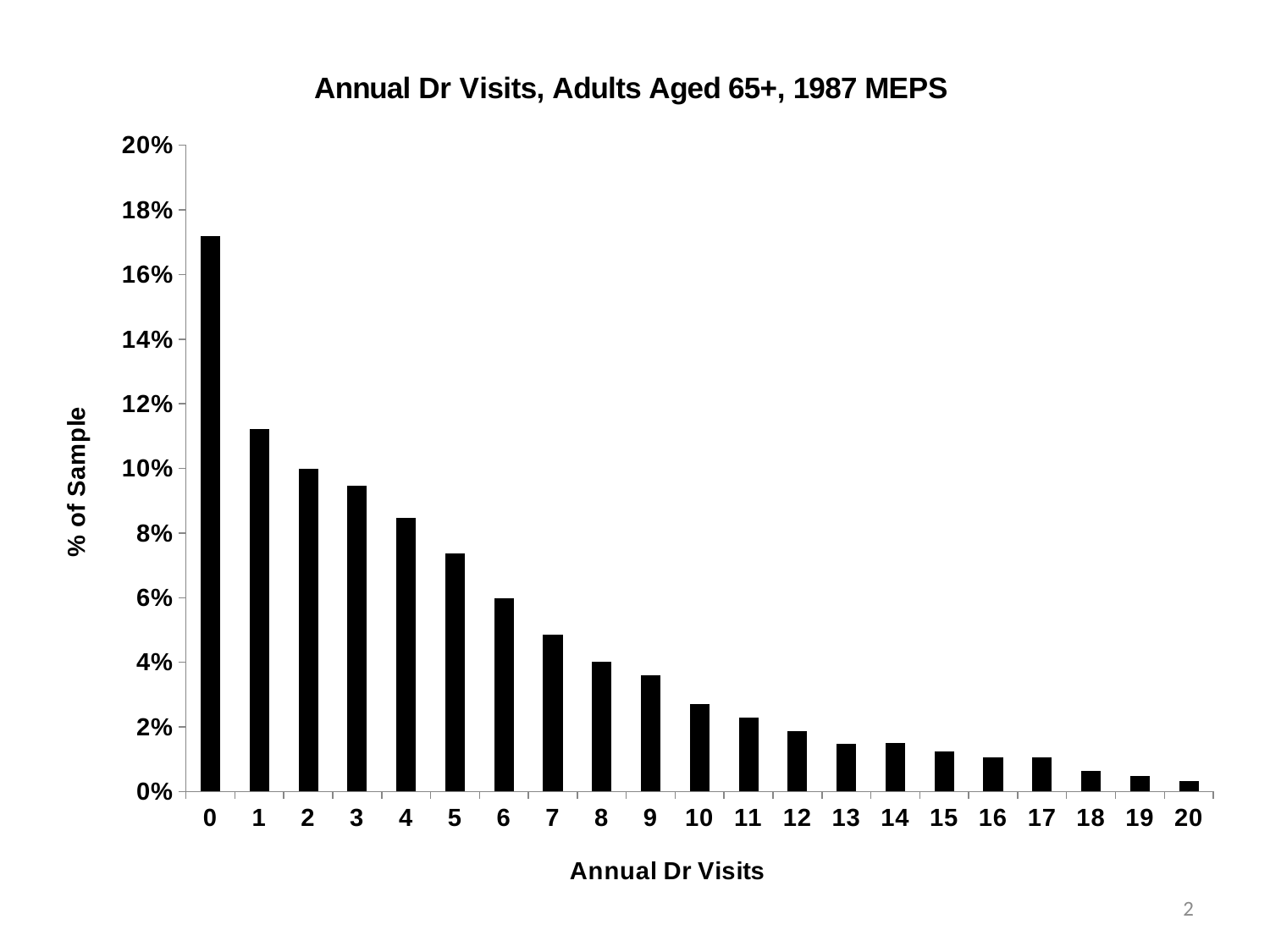
Is the % of sample for 5 annual Dr visits greater or less than 8%? less Which number of annual Dr visits has the lowest % of sample? 20 Which number of annual Dr visits has the highest % of sample? 0 Is the % of sample for 12 annual Dr visits greater or less than 2%? less What is the label on the vertical axis? % of Sample Which has a larger % of sample: 4 annual Dr visits or 5 annual Dr visits? 4 Do the values rise or fall as the number of annual Dr visits increases along the x axis? fall Is the % of sample for 1 annual Dr visit greater or less than 10%? greater What kind of chart is shown on the slide? bar chart How many bars (categories of annual Dr visits) are plotted? 21 What is the title of the chart? Annual Dr Visits, Adults Aged 65+, 1987 MEPS